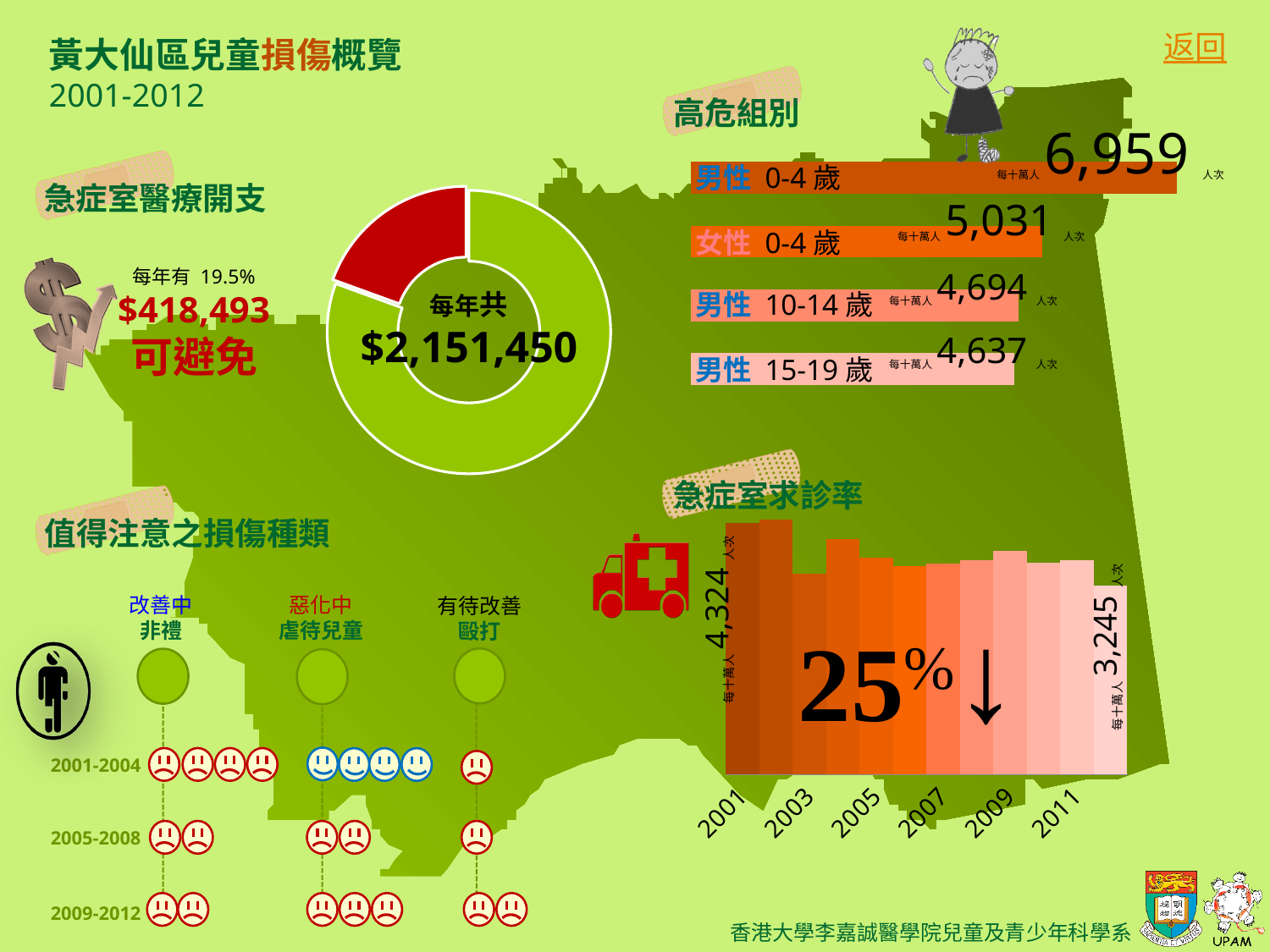
In the 高危組別 bar chart, which group has the lowest value? 男性 15-19 歲 In the 急症室求診率 chart, what is the value labelled on the last bar? 3,245 What kind of chart is the 急症室求診率 chart? bar chart In the 急症室醫療開支 donut chart, what is the total annual amount shown in the centre? $2,151,450 How many groups are shown in the 高危組別 bar chart? 4 In the 高危組別 bar chart, what is the difference between the values for 男性 0-4 歲 and 女性 0-4 歲? 1,928 In the 高危組別 bar chart, which group has the highest value? 男性 0-4 歲 In the 急症室求診率 chart, what is the value labelled on the first bar (2001)? 4,324 In the 高危組別 bar chart, what is the value for 男性 0-4 歲? 6,959 In the 急症室醫療開支 donut chart, what share of the total is marked as 可避免 (avoidable)? 19.5% In the 高危組別 bar chart, what is the value for 女性 0-4 歲? 5,031 In the 急症室求診率 chart, do the values overall rise or fall from 2001 to the last year? fall